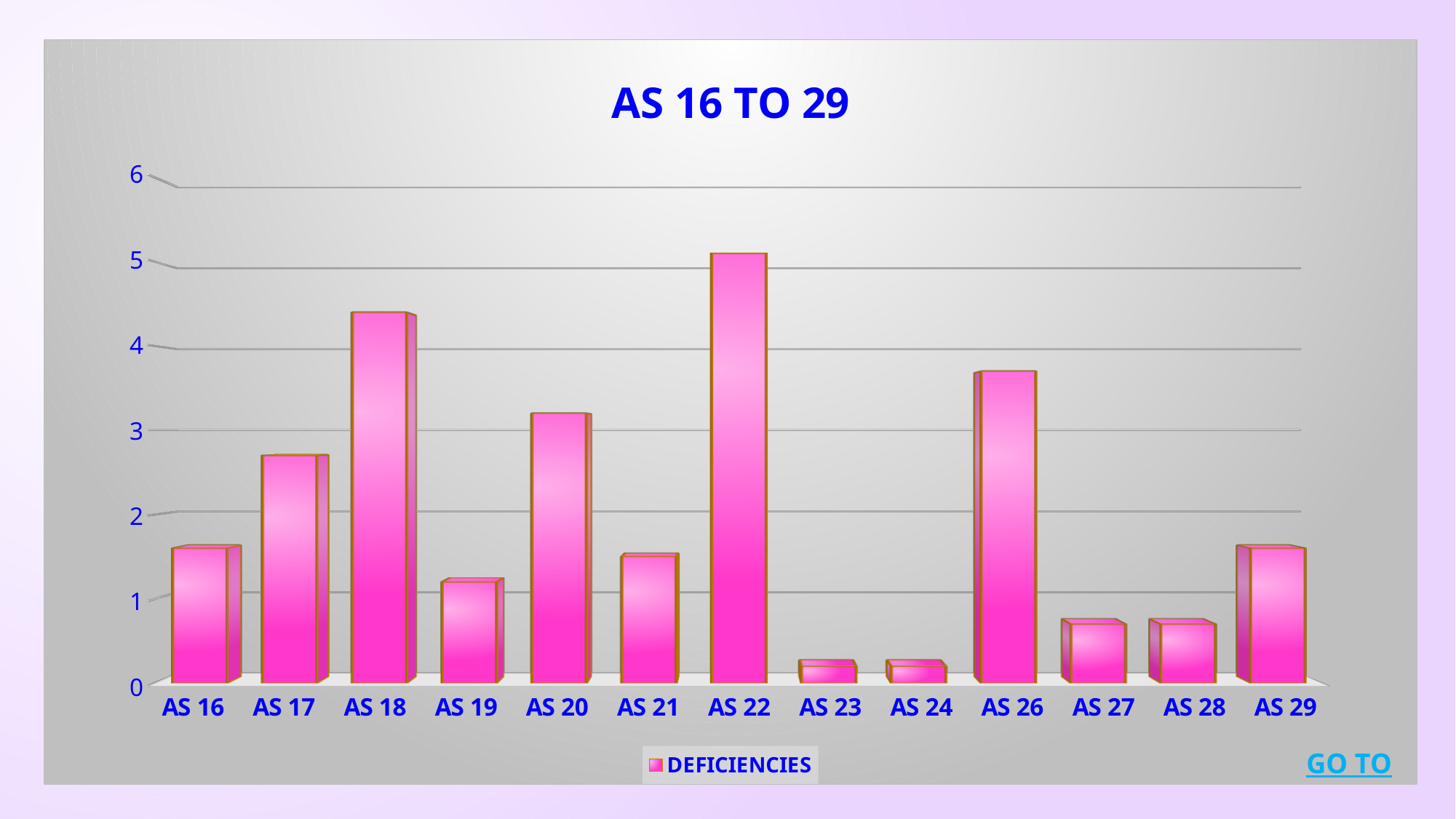
Is the value for AS 17 greater or less than 3? less Which category has the highest value? AS 22 Is the value for AS 26 greater or less than 4? less Which is larger, the value for AS 17 or the value for AS 20? AS 20 How many categories are shown on the x axis? 13 What is the title of the chart? AS 16 TO 29 Which is larger, the value for AS 18 or the value for AS 26? AS 18 Is the value for AS 18 greater or less than 4? greater What is the name of the series shown in the legend? DEFICIENCIES What type of chart is shown on the slide? bar chart How many series does the legend list? 1